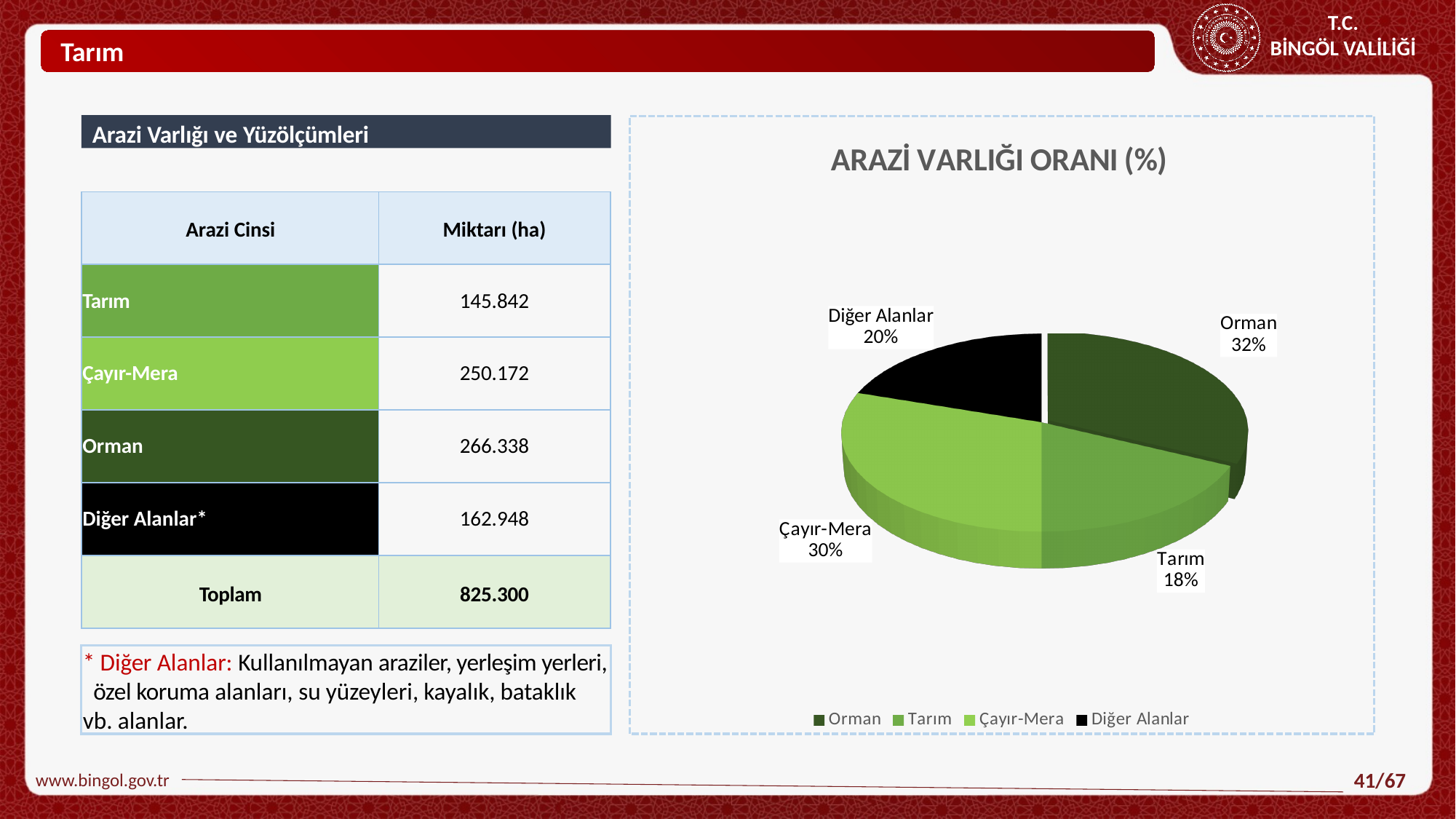
What is the title of the pie chart? ARAZİ VARLIĞI ORANI (%) What kind of chart is shown on the slide? pie chart How many entries does the legend of the pie chart list? 4 Which slice of the pie chart is the smallest? Tarım What is the difference in percentage points between the Orman and Tarım slices? 14 Which slice is larger, Çayır-Mera or Diğer Alanlar? Çayır-Mera Which slice of the pie chart is the largest? Orman What share of the pie does Tarım have? 18% What share of the pie does Orman have? 32% What share of the pie does Çayır-Mera have? 30% How many slices does the pie chart have? 4